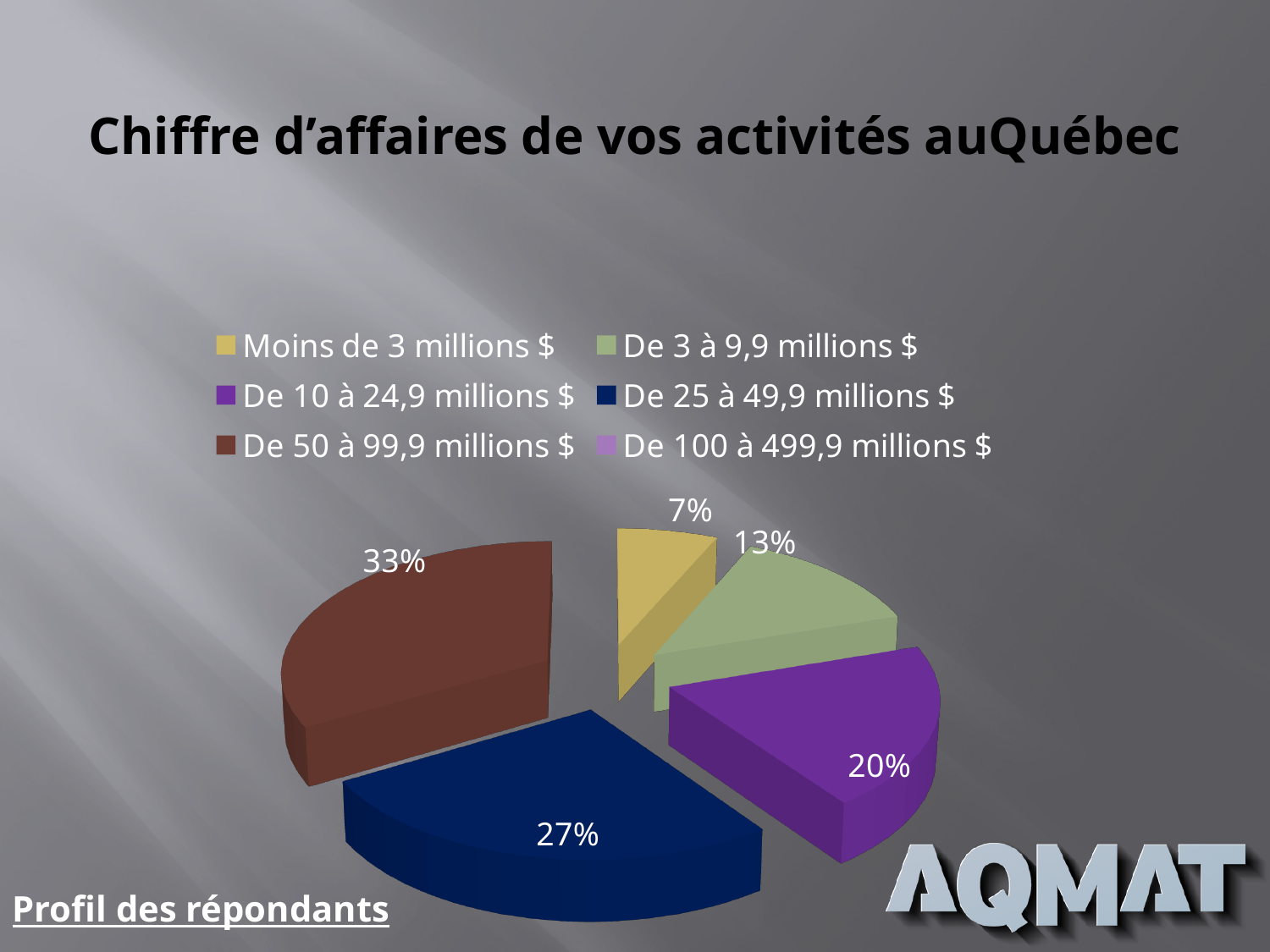
What is the difference in percentage points between 'De 50 à 99,9 millions $' and 'De 25 à 49,9 millions $'? 6 What percentage is shown for 'De 3 à 9,9 millions $'? 13% What type of chart is shown on the slide? pie chart What percentage is shown for 'De 50 à 99,9 millions $'? 33% What is the title of the chart? Chiffre d'affaires de vos activités auQuébec What percentage is shown for 'De 25 à 49,9 millions $'? 27% Which labelled slice has the smallest share of the pie? Moins de 3 millions $ Which category has the largest share of the pie? De 50 à 99,9 millions $ What percentage of respondents are in the 'Moins de 3 millions $' category? 7% Which is larger, the share for 'De 10 à 24,9 millions $' or the share for 'De 3 à 9,9 millions $'? De 10 à 24,9 millions $ What percentage is shown for 'De 10 à 24,9 millions $'? 20% How many categories does the legend list? 6